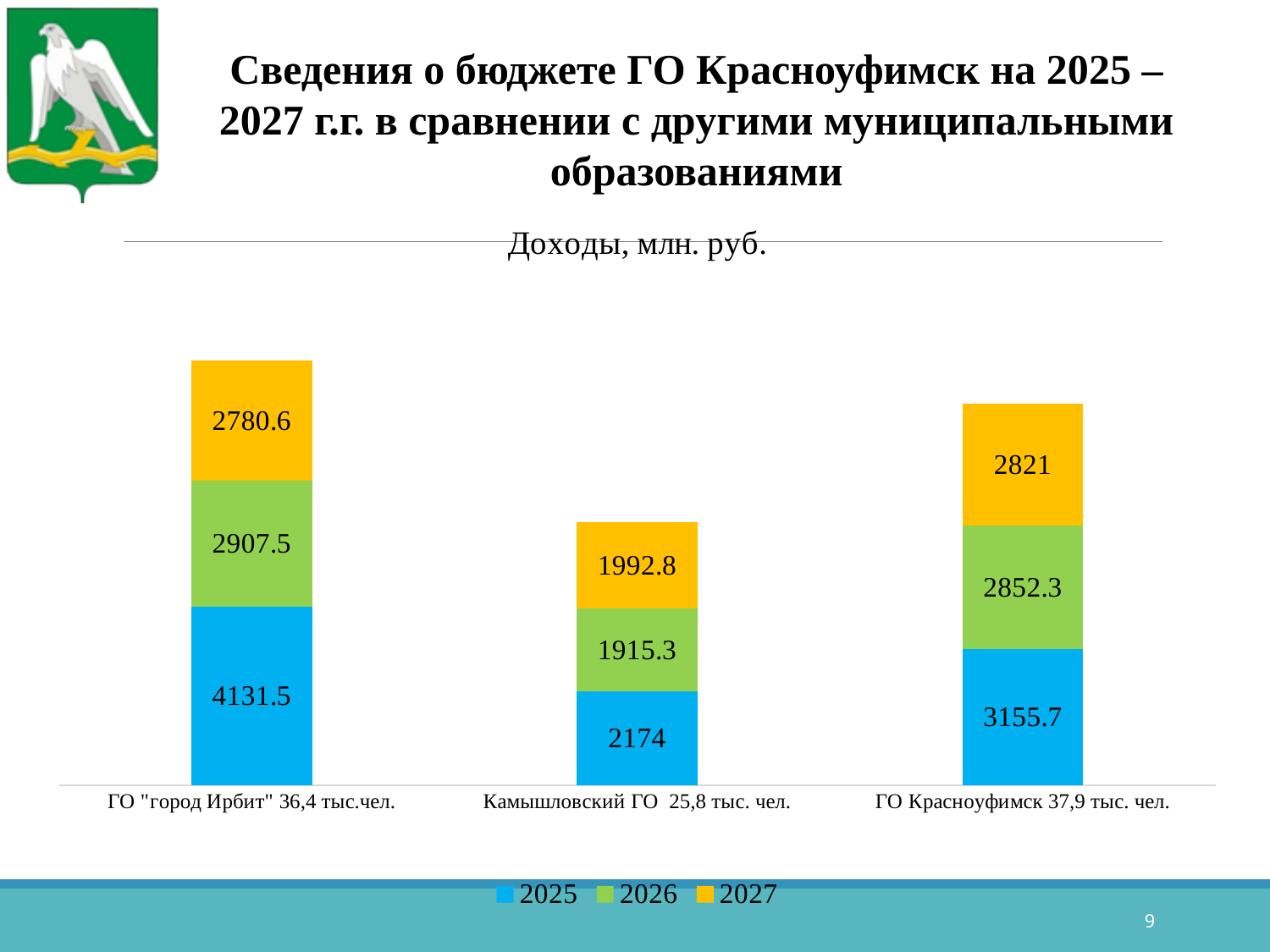
Which is larger: the 2026 value for ГО Красноуфимск or the 2026 value for ГО "город Ирбит"? ГО "город Ирбит" What is the 2025 value for ГО "город Ирбит"? 4131.5 Which municipality has the highest 2025 value? ГО "город Ирбит" What is the total of the stacked bar for Камышловский ГО? 6082.1 What kind of chart is shown on the slide? Stacked bar chart How many series does the legend list? 3 What is the title of the chart? Доходы, млн. руб. What is the difference between the 2025 values for ГО "город Ирбит" and ГО Красноуфимск? 975.8 What is the 2026 value for Камышловский ГО? 1915.3 Which municipality has the lowest 2027 value? Камышловский ГО What is the 2027 value for ГО Красноуфимск? 2821 How many municipalities (categories) are shown on the x axis? 3